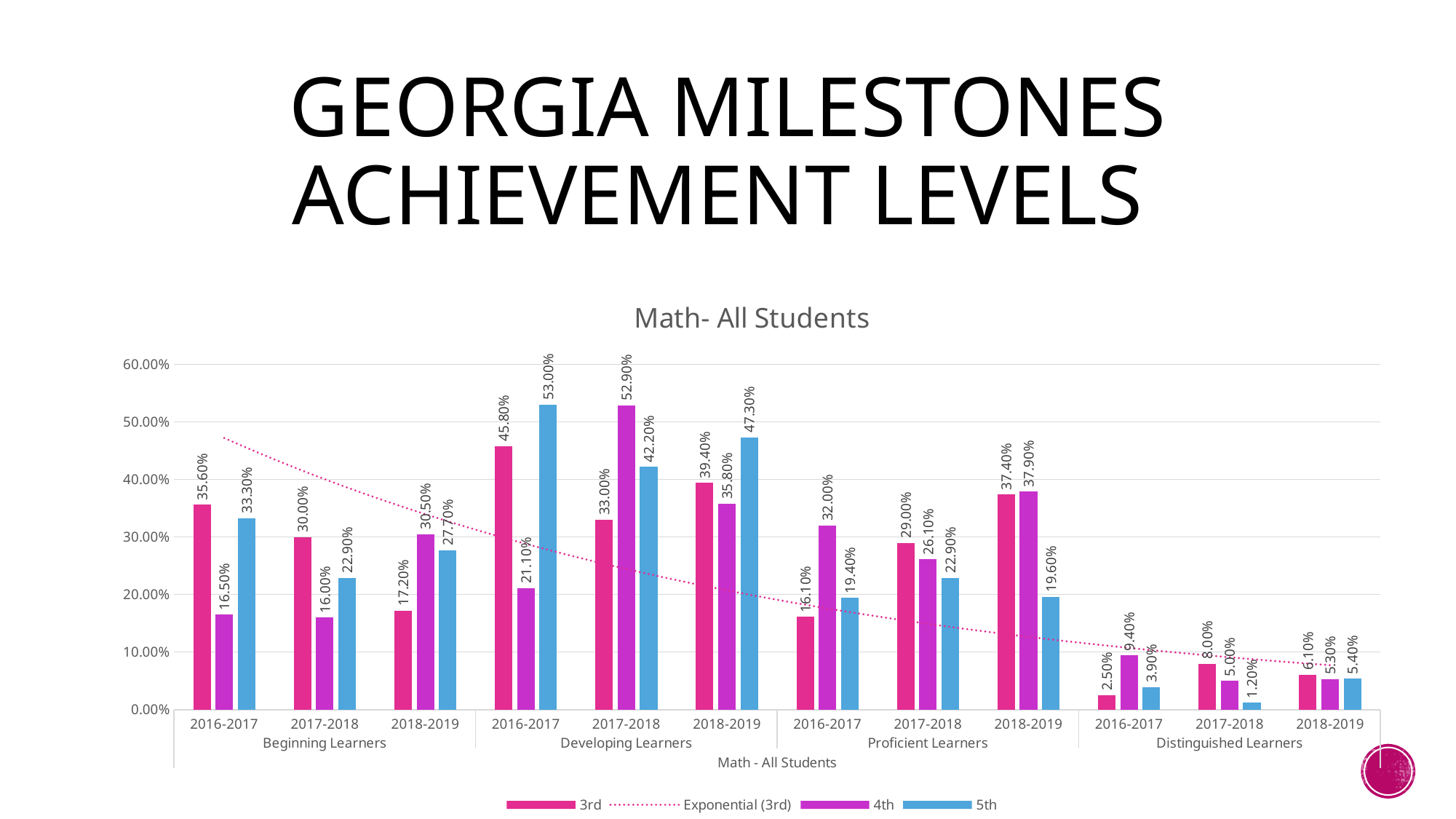
What is the value for 5th grade Developing Learners in 2016-2017? 53.00% What is the value for 3rd grade Beginning Learners in 2016-2017? 35.60% What is the value for 5th grade Distinguished Learners in 2017-2018? 1.20% Does the 3rd grade value for Beginning Learners rise or fall from 2016-2017 to 2018-2019? Fall How many entries does the legend list? 4 Which grade has the highest value for Developing Learners in 2017-2018? 4th Which is larger for Proficient Learners in 2017-2018: the 3rd grade value or the 5th grade value? 3rd grade What type of chart is shown on the slide? Bar chart What is the title of the chart? Math- All Students What is the value for 4th grade Proficient Learners in 2018-2019? 37.90% What is the difference between the 3rd grade and 4th grade values for Beginning Learners in 2016-2017? 19.10% Which grade has the lowest value for Beginning Learners in 2018-2019? 3rd